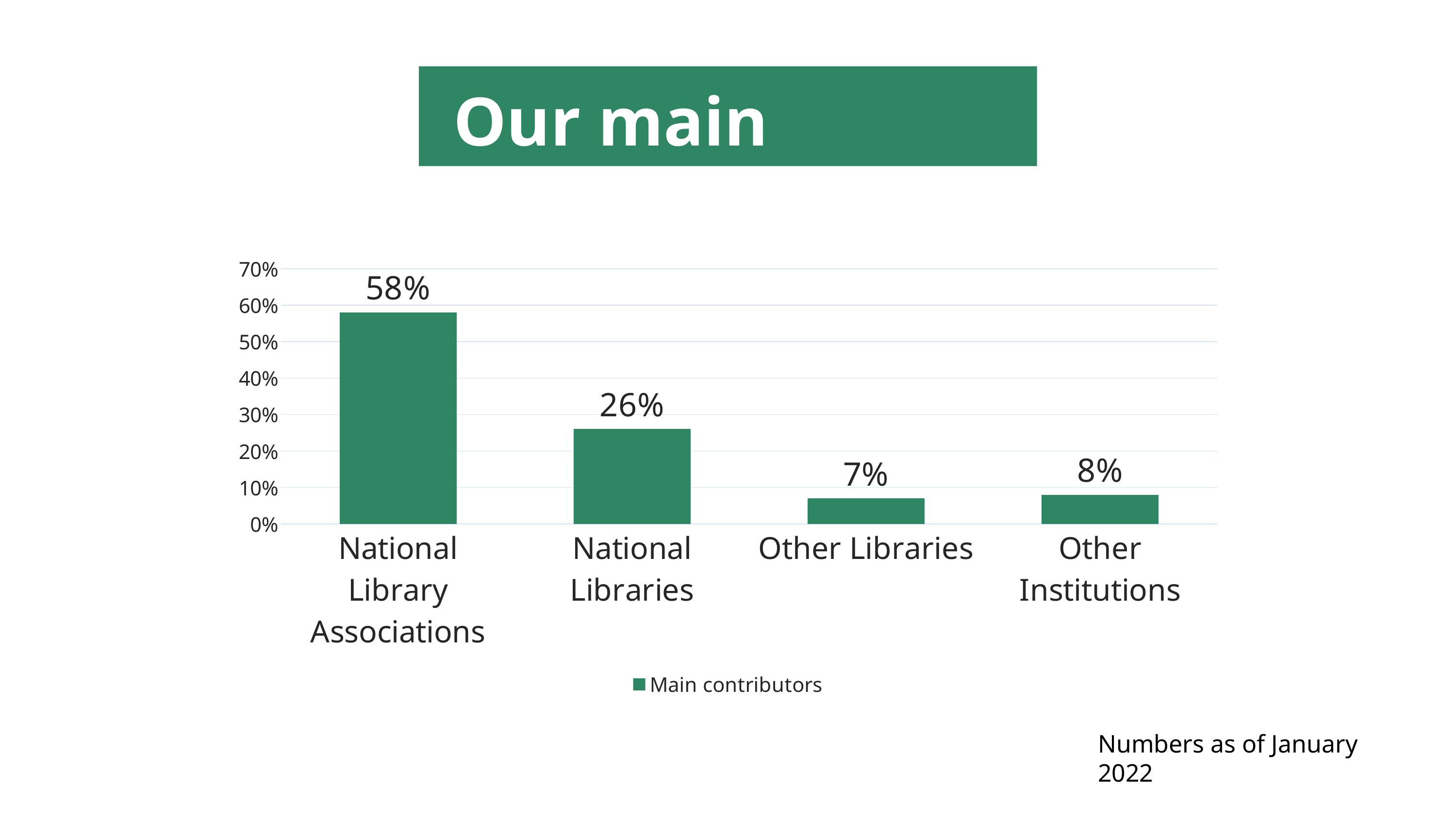
What is the value for Other Libraries? 7% Which category has the lowest value? Other Libraries What is the difference between the values for National Library Associations and National Libraries? 32% What is the value for Other Institutions? 8% What series name does the legend show? Main contributors How many categories are shown on the x axis? 4 Is the value for National Libraries greater or less than 30%? less Which is larger, the value for National Libraries or the value for Other Institutions? National Libraries Which category has the highest value? National Library Associations What is the value for National Libraries? 26% What is the value for National Library Associations? 58% What kind of chart is shown on the slide? bar chart